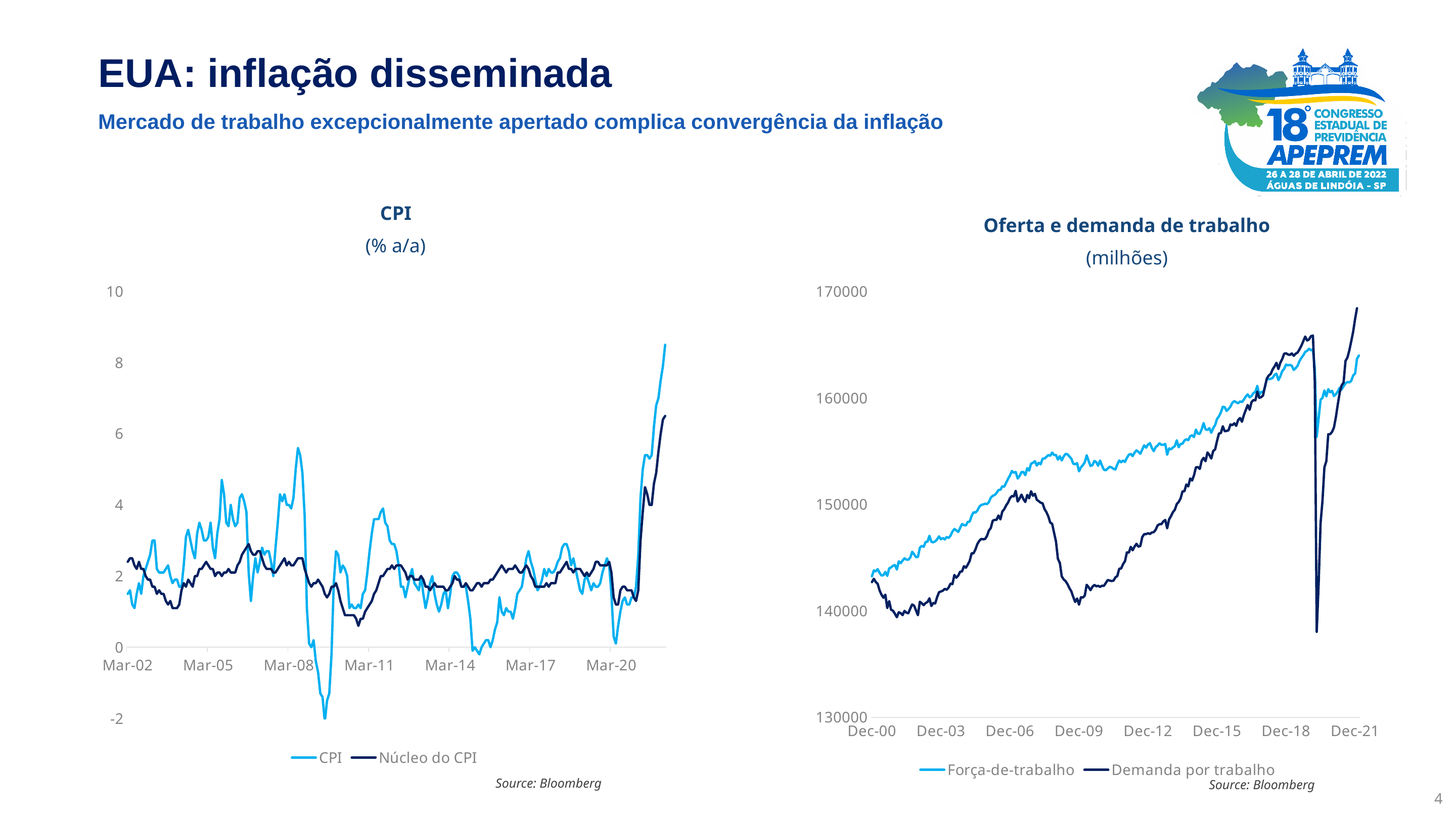
What are the two series named in the legend of the CPI chart? CPI and Núcleo do CPI In the CPI chart, is the final value of the CPI line greater or less than 8? greater What unit is shown in the subtitle of the 'Oferta e demanda de trabalho' chart? milhões In the 'Oferta e demanda de trabalho' chart, is the final value of the Demanda por trabalho line greater or less than 160000? greater In the CPI chart, at the right end of the series, which line is higher: CPI or Núcleo do CPI? CPI How many series does the legend of the CPI chart list? 2 In the 'Oferta e demanda de trabalho' chart, does the Força-de-trabalho line generally rise or fall from Dec-00 to Dec-21? rise How many series does the legend of the 'Oferta e demanda de trabalho' chart list? 2 What kind of chart is the CPI chart on the left? line chart In the CPI chart, is the final value of the Núcleo do CPI line greater or less than 6? greater